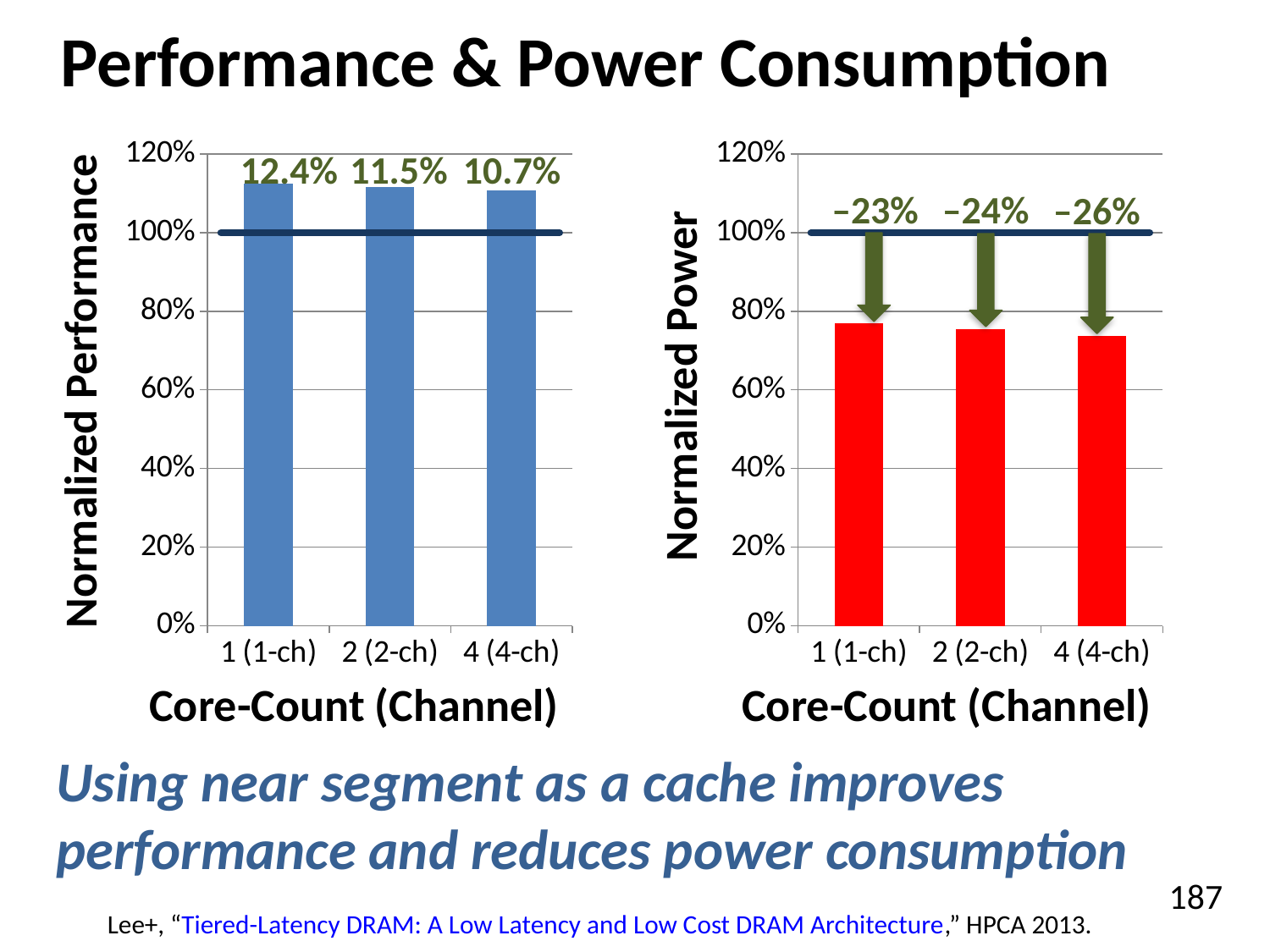
On the Normalized Performance chart (left), what improvement is labeled above the bar for 4 (4-ch)? 10.7% On the Normalized Power chart (right), do the bar values rise or fall as the core-count increases from 1 (1-ch) to 4 (4-ch)? fall On the Normalized Performance chart (left), which core-count has the highest normalized performance? 1 (1-ch) On the Normalized Performance chart (left), is the value for 2 (2-ch) greater or less than 100%? greater On the Normalized Power chart (right), which core-count has the lowest normalized power? 4 (4-ch) On the Normalized Power chart (right), what reduction is labeled above the bar for 2 (2-ch)? –24% On the Normalized Power chart (right), what reduction is labeled above the bar for 4 (4-ch)? –26% On the Normalized Performance chart (left), how many core-count categories are shown? 3 On the Normalized Performance chart (left), what improvement is labeled above the bar for 1 (1-ch)? 12.4% On the Normalized Power chart (right), is the value for 1 (1-ch) greater or less than 80%? less What is the x-axis title of the Normalized Performance chart (left)? Core-Count (Channel) What kind of chart is the Normalized Power chart (right)? bar chart